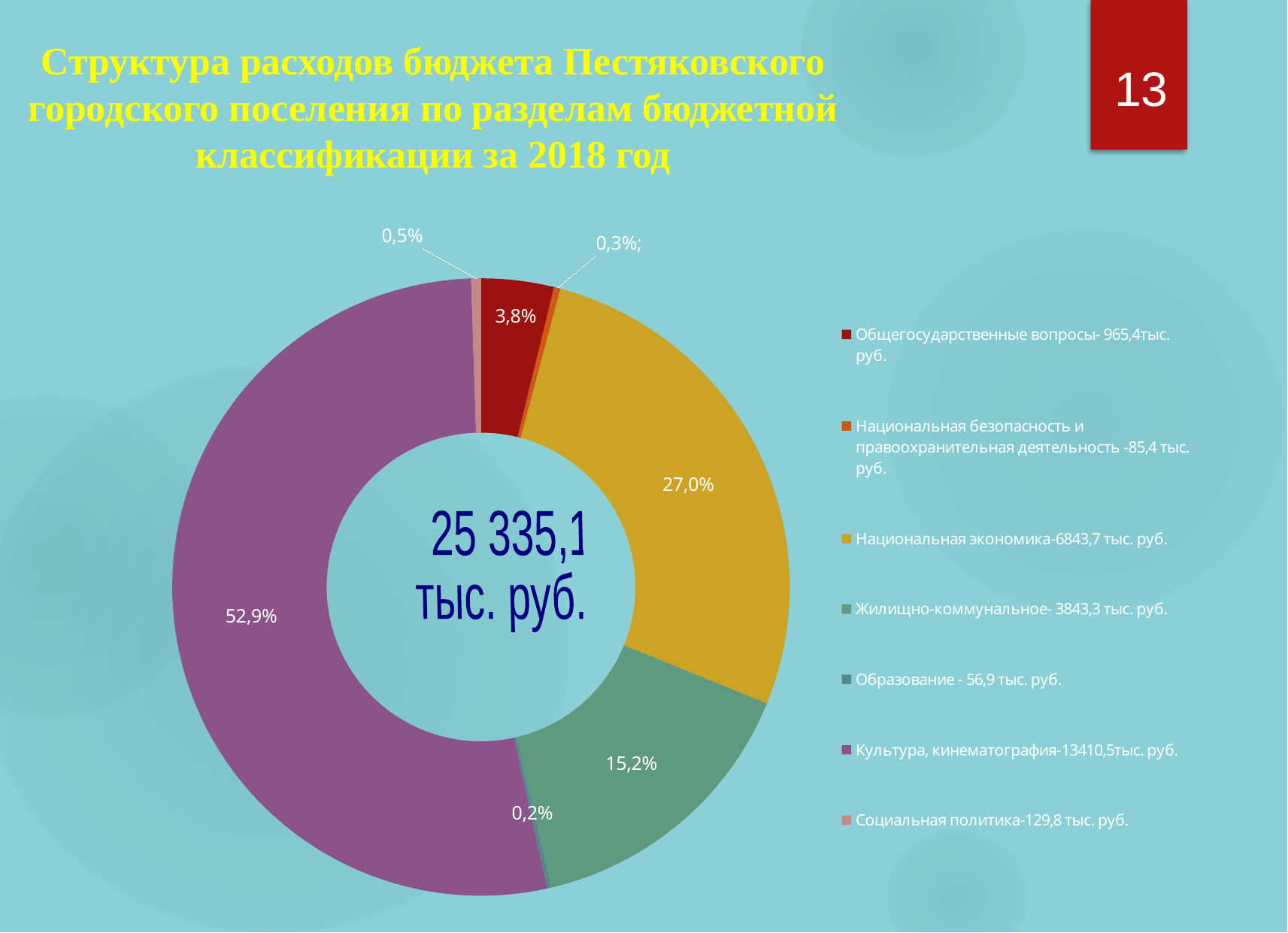
According to the legend, what is the expenditure on Национальная экономика? 6843,7 тыс. руб. Which section has the smallest share of the budget expenditure? Образование Which is larger: the share for Национальная экономика or the share for Жилищно-коммунальное? Национальная экономика What share of the budget expenditure does Национальная экономика account for? 27,0% What kind of chart is shown on the slide? Doughnut (pie) chart What share of the budget expenditure does Общегосударственные вопросы account for? 3,8% How many categories does the legend of the chart list? 7 Which section has the largest share of the budget expenditure? Культура, кинематография What share of the budget expenditure does Жилищно-коммунальное account for? 15,2% According to the legend, what is the expenditure on Социальная политика? 129,8 тыс. руб. What is the total budget expenditure shown in the centre of the chart? 25 335,1 тыс. руб.